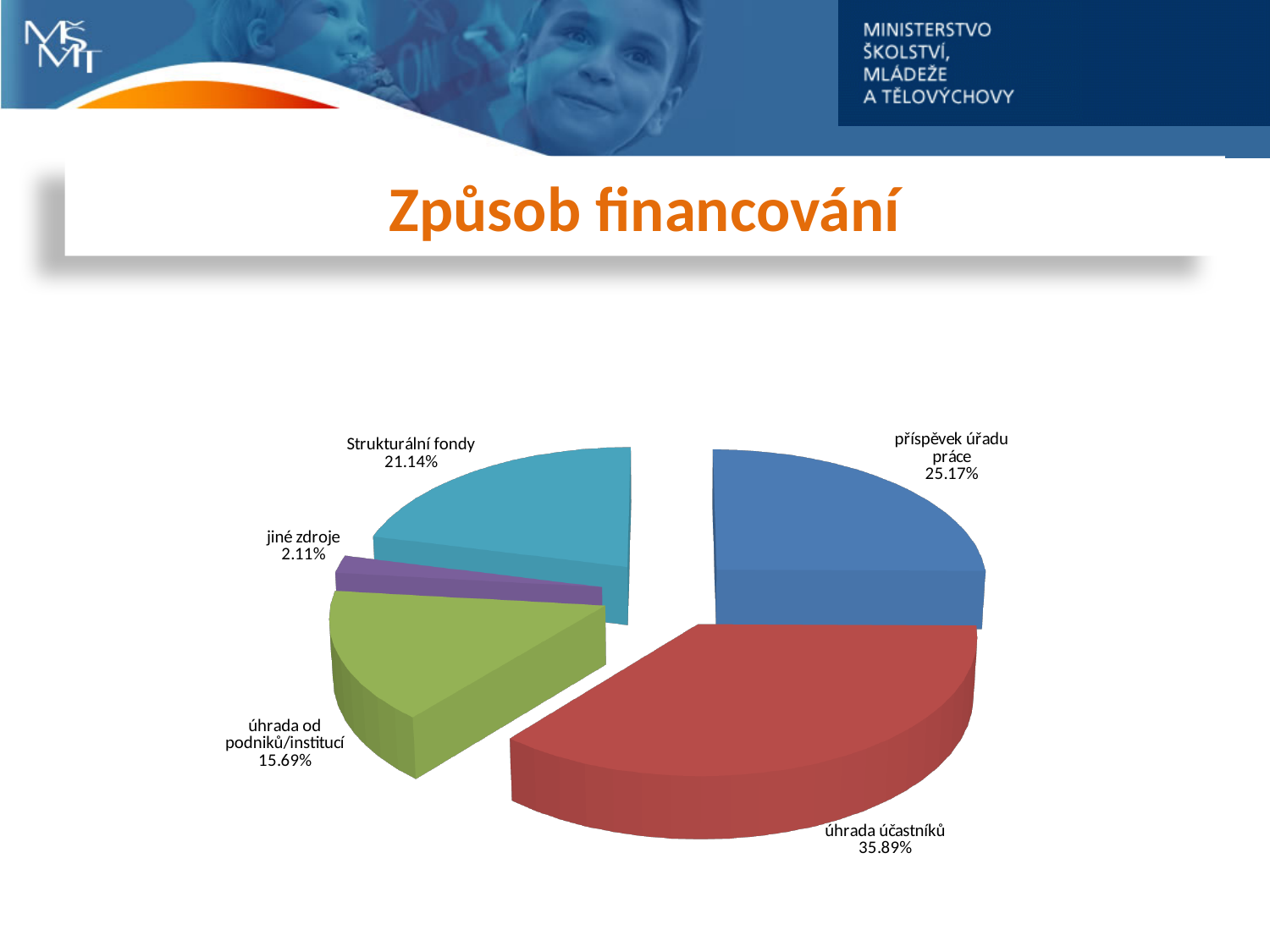
Which category has the largest share of the pie? úhrada účastníků What share of the pie does 'příspěvek úřadu práce' have? 25.17% What share of the pie does 'úhrada účastníků' have? 35.89% What share of the pie does 'úhrada od podniků/institucí' have? 15.69% What is the difference in percentage points between 'úhrada účastníků' and 'příspěvek úřadu práce'? 10.72 How many categories (slices) does the pie chart have? 5 What kind of chart is shown on the slide? pie chart What is the title of the slide containing the chart? Způsob financování Which is larger, the share for 'Strukturální fondy' or the share for 'úhrada od podniků/institucí'? Strukturální fondy Which category has the smallest share of the pie? jiné zdroje